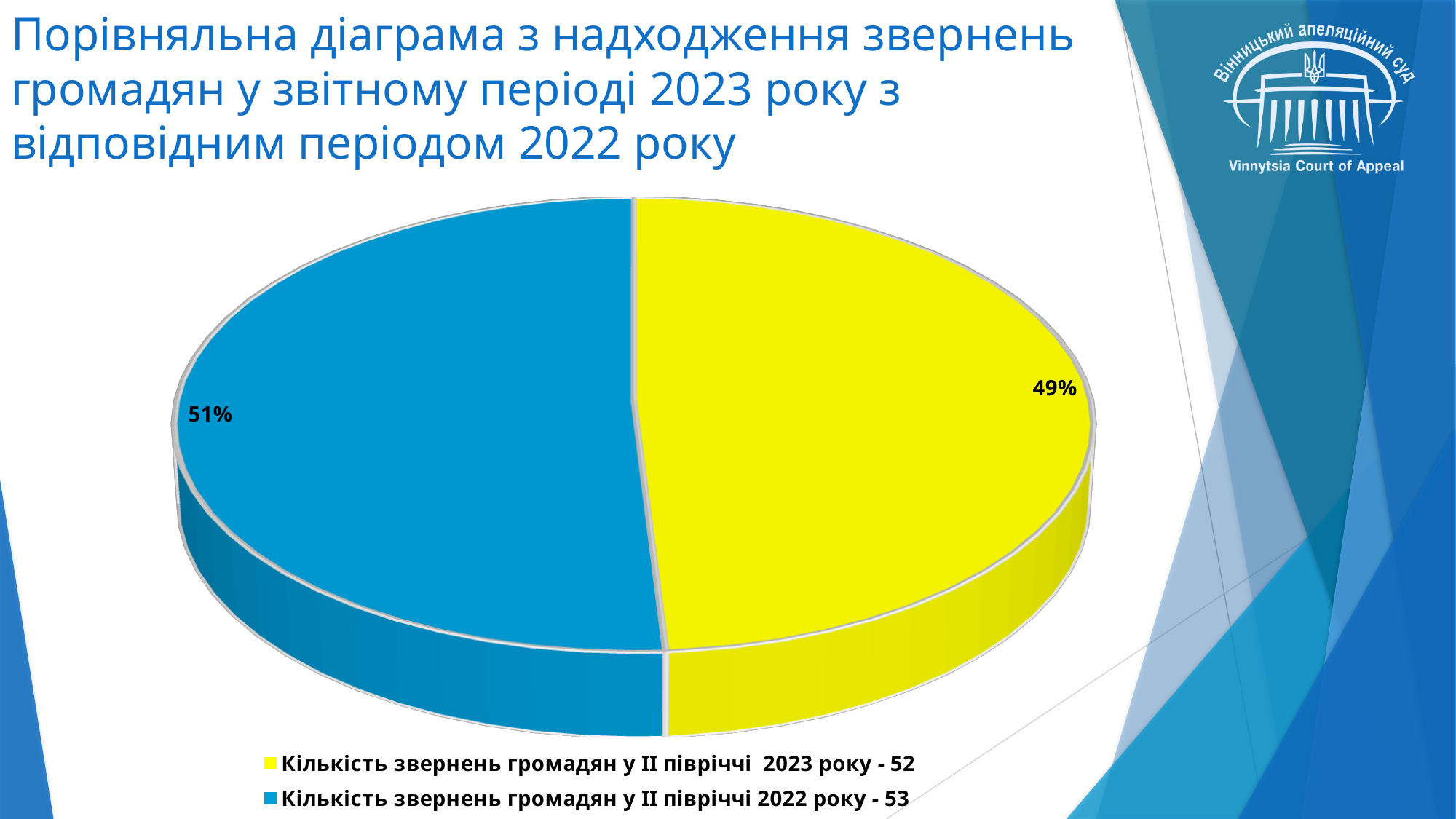
What share of the pie does the slice for appeals in the second half of 2022 represent? 51% What is the difference in percentage points between the two slices of the pie? 2% What share of the pie does the slice for appeals in the second half of 2023 represent? 49% What colour is the slice representing appeals in the second half of 2023? Yellow According to the legend, how many citizen appeals were received in the second half of 2022? 53 How many entries does the legend list? 2 Which period has the larger slice of the pie, the second half of 2023 or the second half of 2022? Second half of 2022 How many slices does the pie chart have? 2 What is the difference between the number of appeals in the second half of 2022 and the second half of 2023? 1 Which period has the smallest share of the pie? Second half of 2023 What kind of chart is shown on the slide? Pie chart According to the legend, how many citizen appeals were received in the second half of 2023? 52